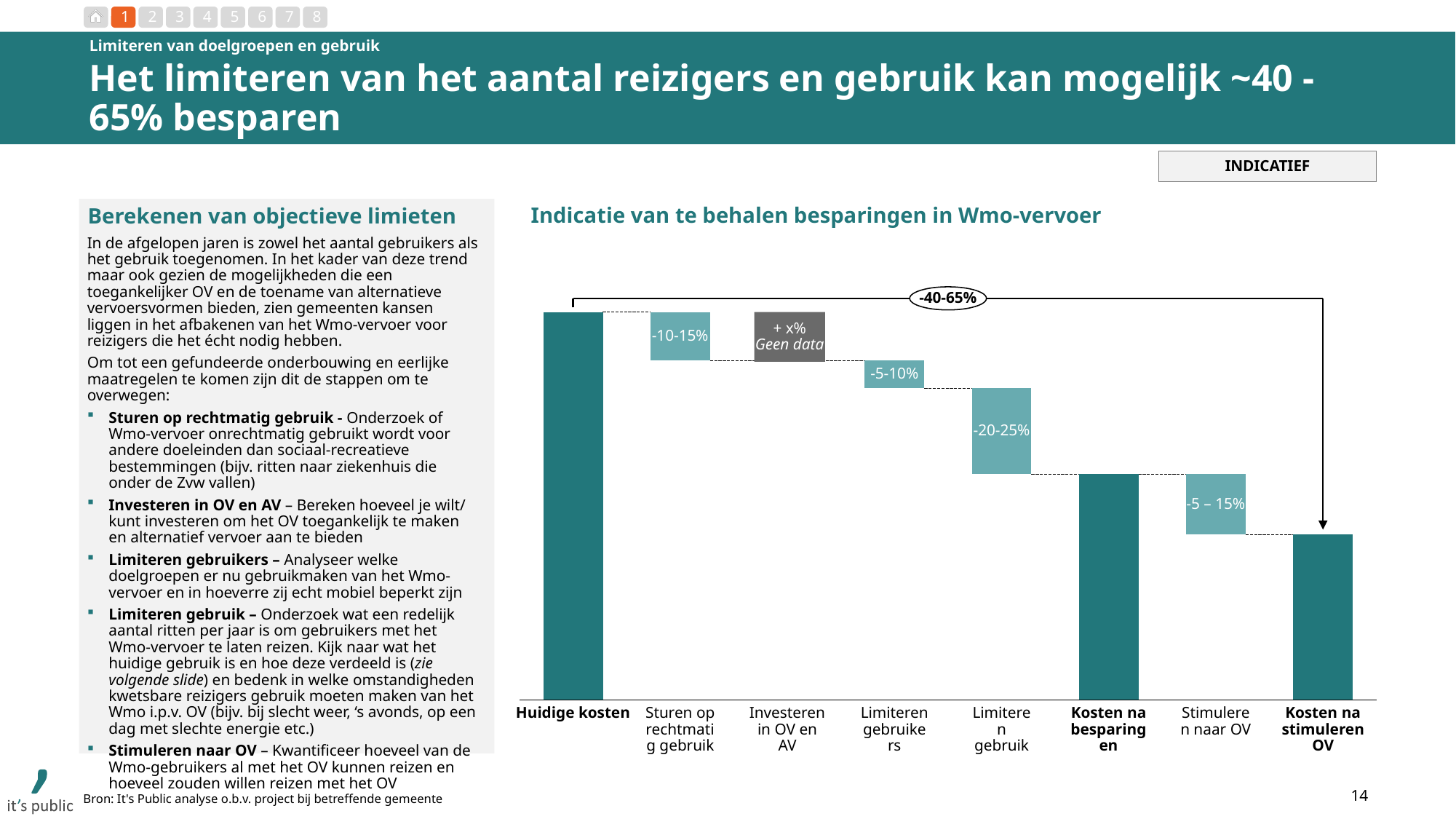
What saving percentage is labelled on the bar for 'Limiteren gebruik'? -20-25% How many categories are shown along the x axis of the chart? 8 What saving percentage is labelled on the bar for 'Limiteren gebruikers'? -5-10% What kind of chart is shown on the slide? Waterfall bar chart What saving percentage is labelled on the bar for 'Stimuleren naar OV'? -5 – 15% What saving percentage is labelled on the bar for 'Sturen op rechtmatig gebruik'? -10-15% Which category in the chart is marked as having no data? Investeren in OV en AV Which bar is larger: 'Limiteren gebruik' or 'Limiteren gebruikers'? Limiteren gebruik What is the title of the chart? Indicatie van te behalen besparingen in Wmo-vervoer Which measure shows the largest saving percentage in the chart? Limiteren gebruik What total saving range is shown in the bracket above the chart? -40-65% What is labelled on the bar for 'Investeren in OV en AV'? + x% Geen data